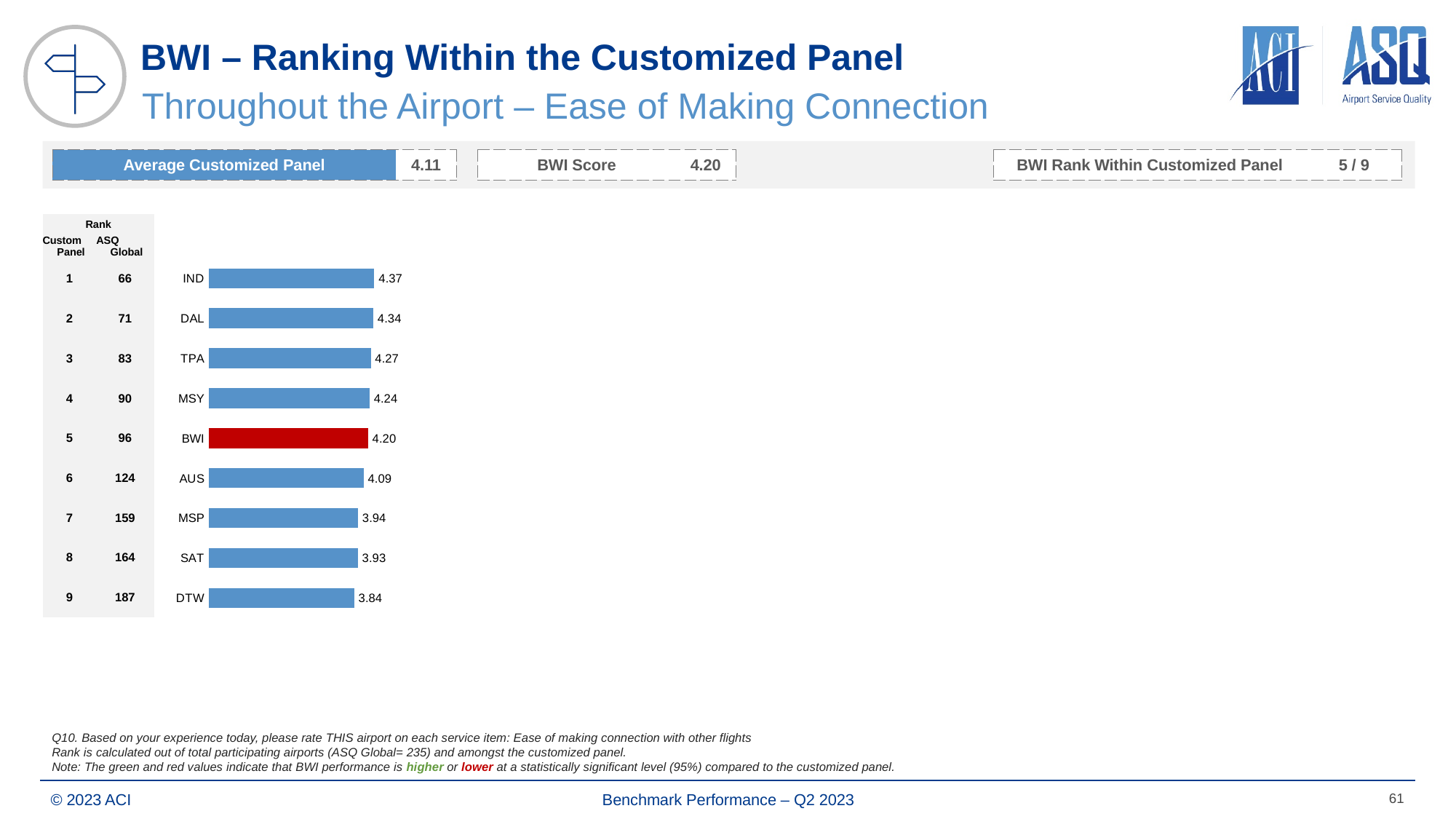
What is the difference between the values for BWI and DTW? 0.36 Which bar in the chart is coloured red? BWI Which airport has the highest value in the bar chart? IND How many airports are shown in the bar chart? 9 What is the value for BWI in the bar chart? 4.20 What kind of chart is shown on the slide? bar chart Do the values rise or fall going down the bar chart from IND to DTW? fall What is the difference between the values for IND and BWI? 0.17 What is the value for IND in the bar chart? 4.37 Which has a larger value, TPA or AUS? TPA Which airport has the lowest value in the bar chart? DTW What is the value for DTW in the bar chart? 3.84